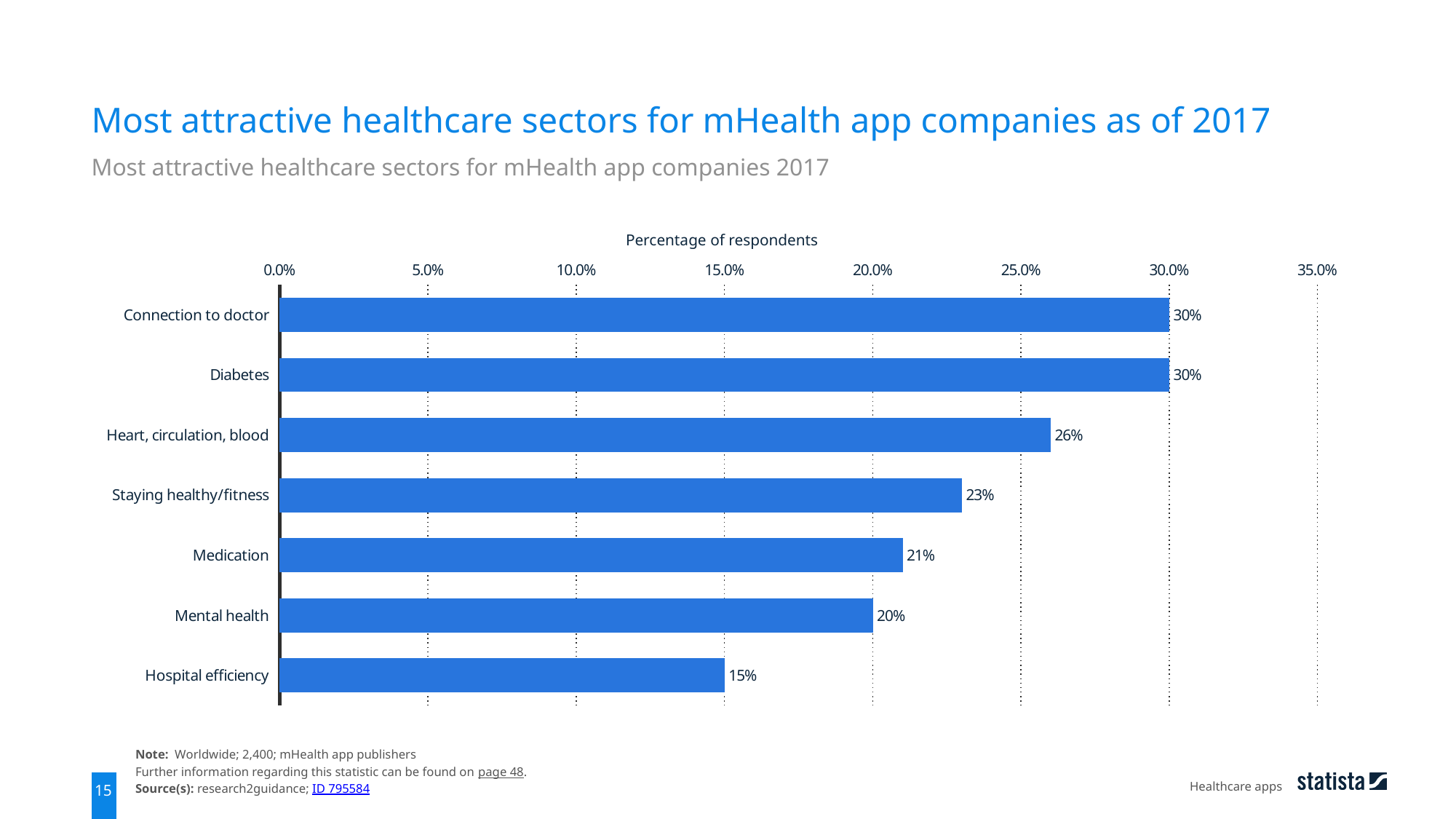
Which is larger, Heart, circulation, blood or Staying healthy/fitness? Heart, circulation, blood Which is larger, Medication or Mental health? Medication What is the difference between Staying healthy/fitness and Mental health? 3% What is the value for Hospital efficiency? 15% Which category has the lowest value? Hospital efficiency What is the value for Diabetes? 30% How many categories are shown in the chart? 7 What percentage of respondents chose Heart, circulation, blood? 26% What is the label of the horizontal axis? Percentage of respondents What is the difference between Connection to doctor and Hospital efficiency? 15% What percentage of respondents chose Medication? 21% What kind of chart is shown on the slide? Bar chart